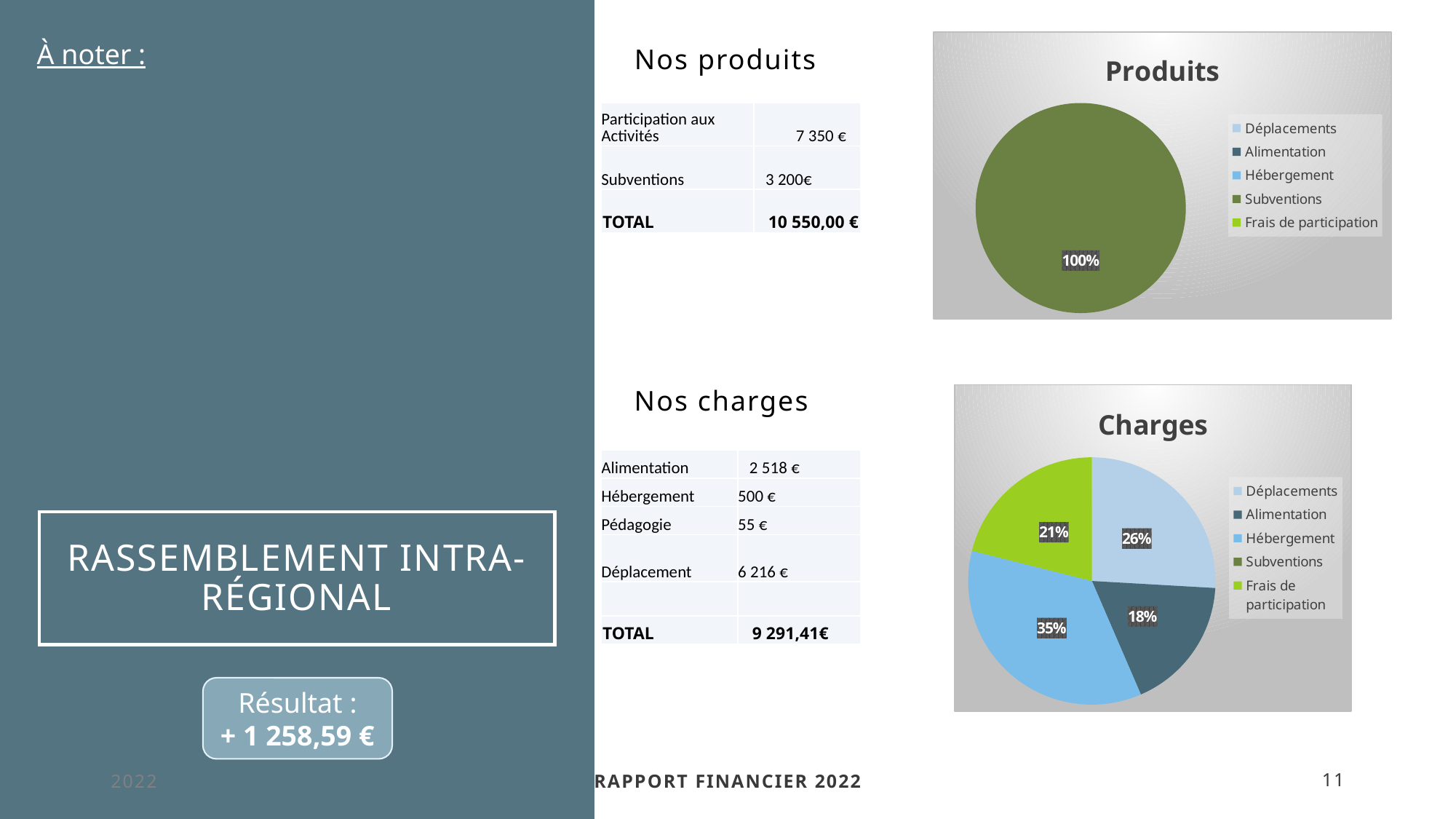
What kind of chart is the "Charges" chart? pie chart In the "Charges" chart, which category has the smallest slice? Alimentation How many slices does the "Charges" pie chart have? 4 In the "Charges" chart, which is larger, the Déplacements slice or the Frais de participation slice? Déplacements In the "Charges" chart, what is the difference in percentage points between the Hébergement slice and the Alimentation slice? 17 In the "Charges" chart, which category has the largest slice? Hébergement In the "Charges" chart, what share does Déplacements have? 26% In the "Charges" chart, what share does Hébergement have? 35% In the "Charges" chart, what share does Alimentation have? 18% How many entries does the legend of the "Produits" chart list? 5